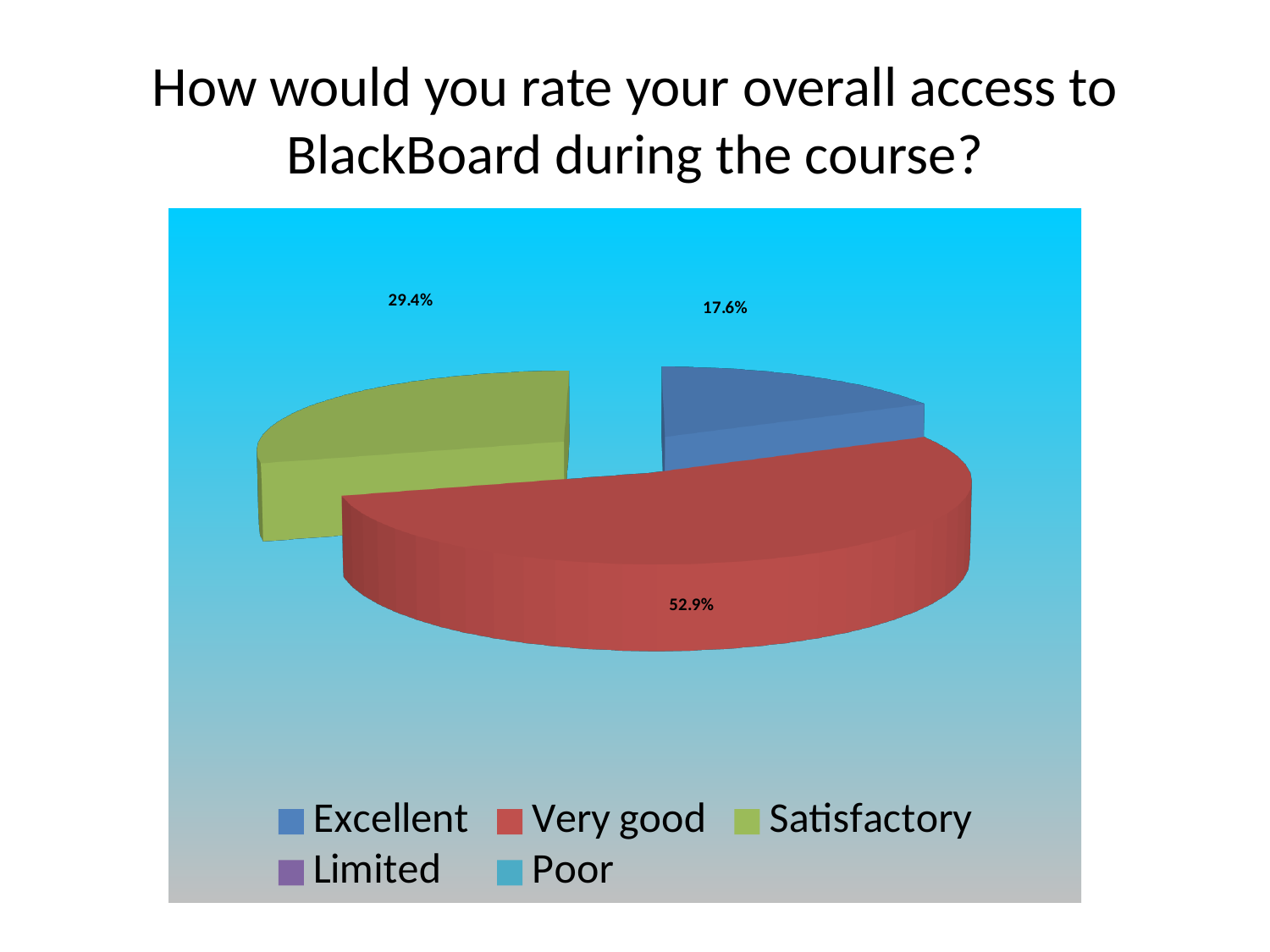
What percentage of respondents rated their access to BlackBoard as Excellent? 17.6% What is the difference in percentage points between the Satisfactory and Excellent shares? 11.8 What percentage of respondents rated their access to BlackBoard as Satisfactory? 29.4% Which rating has the largest share of the pie? Very good Which is larger, the share for Satisfactory or the share for Excellent? Satisfactory What colour is the Very good slice? red What kind of chart is shown on the slide? pie chart How many categories does the legend list? 5 How many slices with a printed value are visible in the pie? 3 What is the difference in percentage points between the Very good and Satisfactory shares? 23.5 What percentage of respondents rated their access to BlackBoard as Very good? 52.9% Of the slices shown with a value, which rating has the smallest share? Excellent